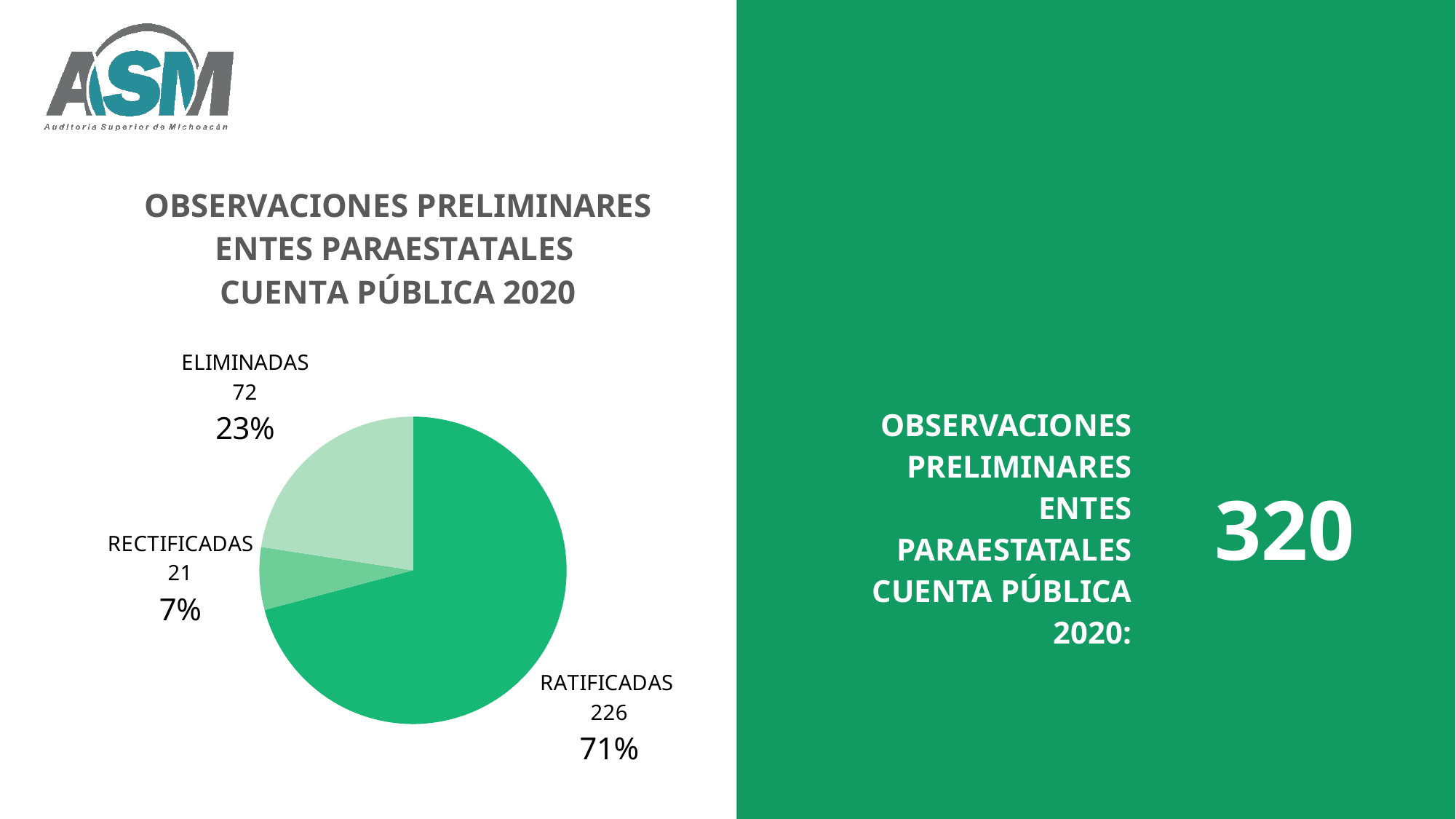
What is the value for ELIMINADAS? 72 Which category has the smallest slice? RECTIFICADAS What is the value for RATIFICADAS? 226 What share of the pie does RATIFICADAS represent? 71% Which category has the largest slice? RATIFICADAS What is the difference between the values for RATIFICADAS and ELIMINADAS? 154 What share of the pie does ELIMINADAS represent? 23% What is the title of the chart? OBSERVACIONES PRELIMINARES ENTES PARAESTATALES CUENTA PÚBLICA 2020 Which is larger, ELIMINADAS or RECTIFICADAS? ELIMINADAS What is the value for RECTIFICADAS? 21 How many slices does the pie chart have? 3 What kind of chart is shown on the slide? pie chart